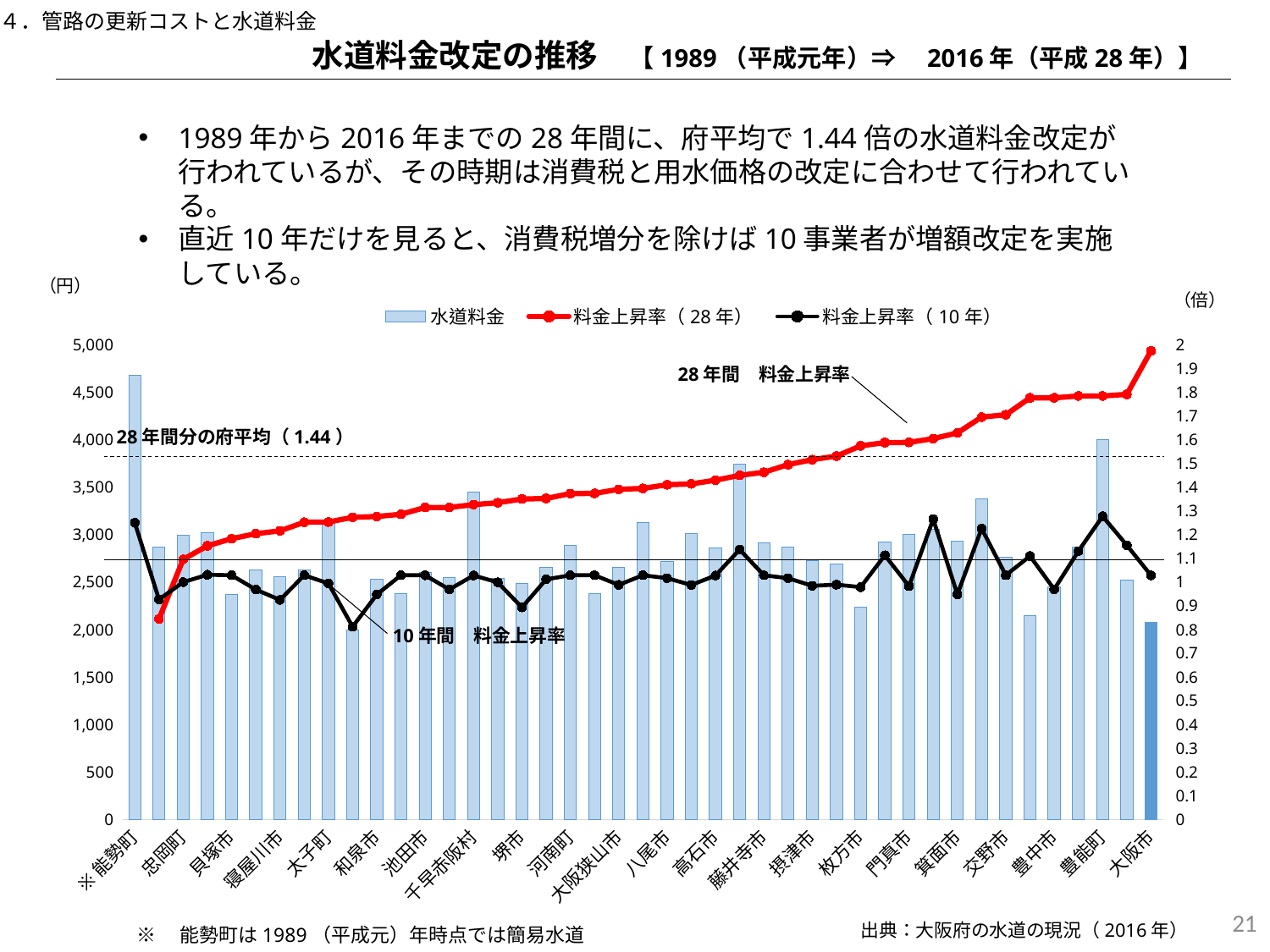
Does the 料金上昇率（28年） line rise or fall from left to right across the municipalities? rises Which municipality has the highest 水道料金 bar? ※能勢町 What are the three series listed in the chart legend? 水道料金, 料金上昇率（28年）, 料金上昇率（10年） Is the 水道料金 bar for 大阪市 greater or less than 2,500? less What value is given for the 28年間分の府平均 reference line? 1.44 Is the 水道料金 bar for ※能勢町 greater or less than 4,000? greater At 大阪市, which line is higher: 料金上昇率（28年） or 料金上昇率（10年）? 料金上昇率（28年） Is the 料金上昇率（28年） value for 大阪市 greater or less than 1.5? greater How many series does the chart legend list? 3 What kind of chart is shown on the slide? A bar chart combined with line charts What is the title of the chart? 水道料金改定の推移 【1989（平成元年）⇒ 2016年（平成28年）】